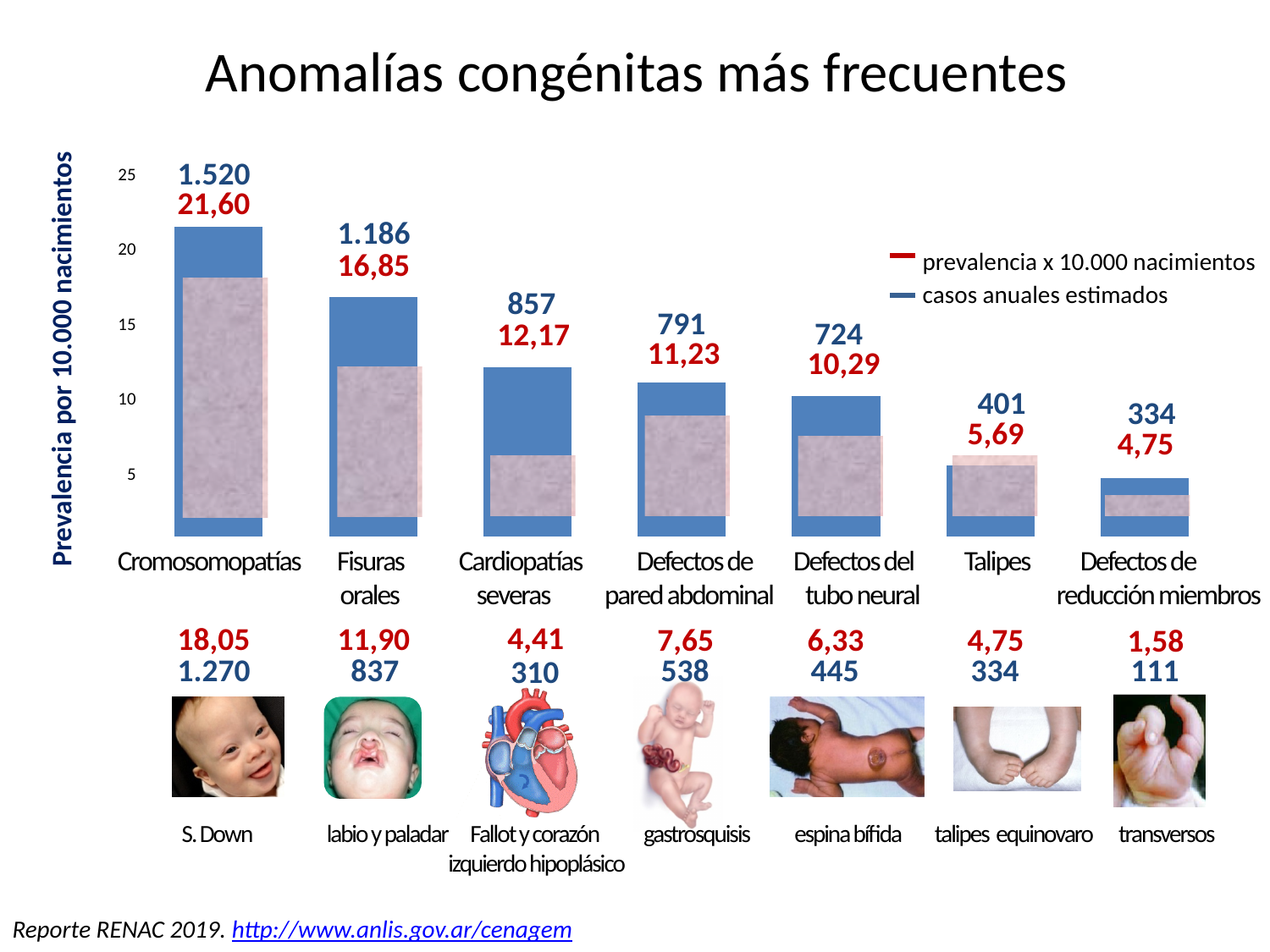
What is the difference in casos anuales estimados between Cromosomopatías and Fisuras orales? 334 Which category has the lowest casos anuales estimados? Defectos de reducción miembros What is the prevalencia x 10.000 nacimientos for Defectos del tubo neural? 10,29 Do the prevalencia values rise or fall from left to right along the x axis? Fall What is the prevalencia x 10.000 nacimientos for Cromosomopatías? 21,60 Which has a higher prevalencia x 10.000 nacimientos, Cardiopatías severas or Defectos de pared abdominal? Cardiopatías severas What kind of chart is shown on the slide? Bar chart What is the casos anuales estimados value for Fisuras orales? 1.186 How many categories are shown on the x axis of the chart? 7 Which category has the highest prevalencia x 10.000 nacimientos? Cromosomopatías How many series does the legend list? 2 What is the casos anuales estimados value for Talipes? 401